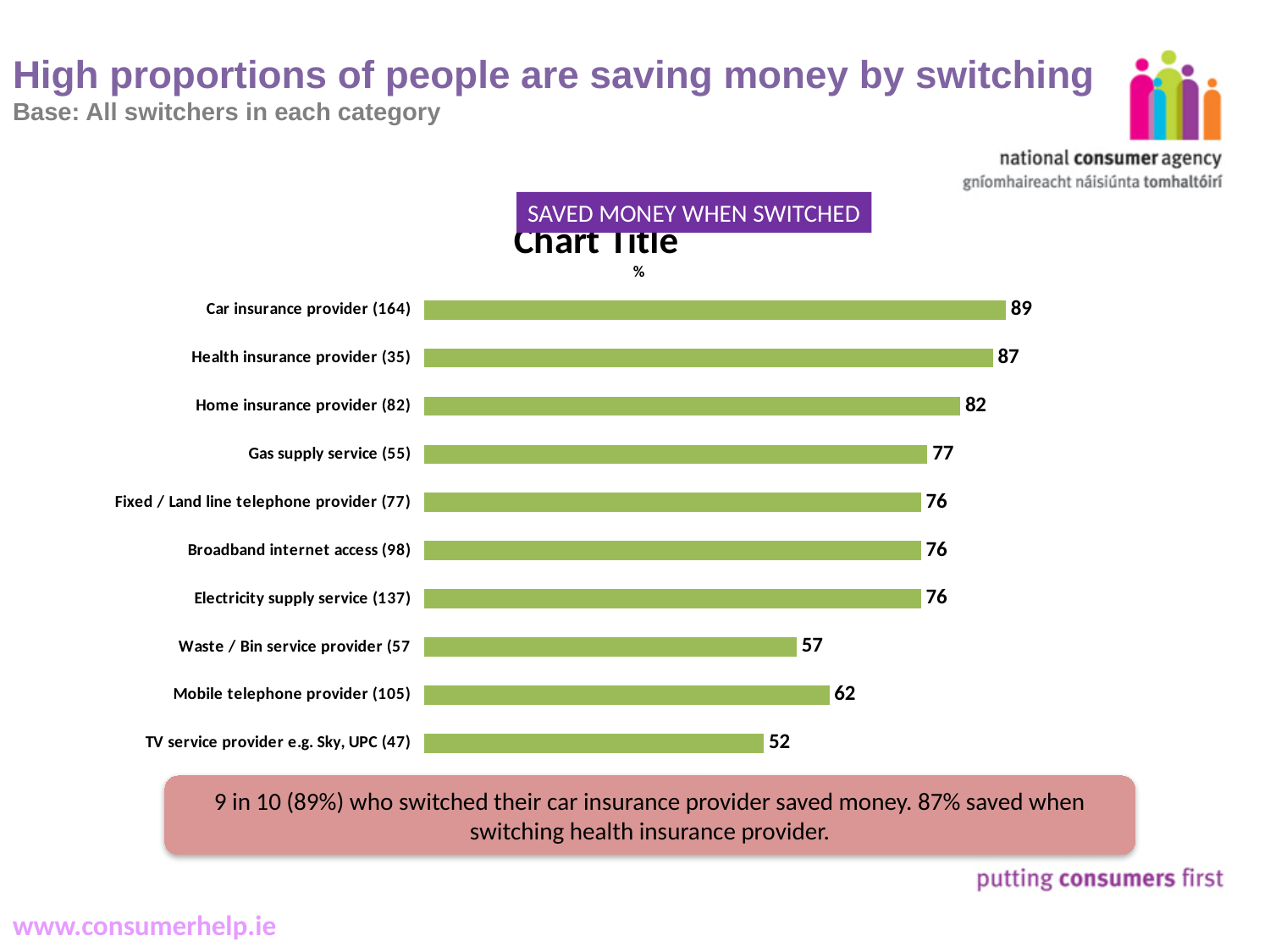
Which is larger, the value for Home insurance provider (82) or the value for Gas supply service (55)? Home insurance provider (82) What is the value for Gas supply service (55)? 77 Which category has the highest value? Car insurance provider (164) How many categories are shown in the chart? 10 Which category has the lowest value? TV service provider e.g. Sky, UPC (47) What is the value for Car insurance provider (164)? 89 What kind of chart is shown on the slide? Bar chart What is the difference between the values for Car insurance provider (164) and Health insurance provider (35)? 2 What is the text in the purple box above the chart? SAVED MONEY WHEN SWITCHED What is the difference between the values for Mobile telephone provider (105) and Waste / Bin service provider (57)? 5 What is the value for TV service provider e.g. Sky, UPC (47)? 52 What is the value for Mobile telephone provider (105)? 62